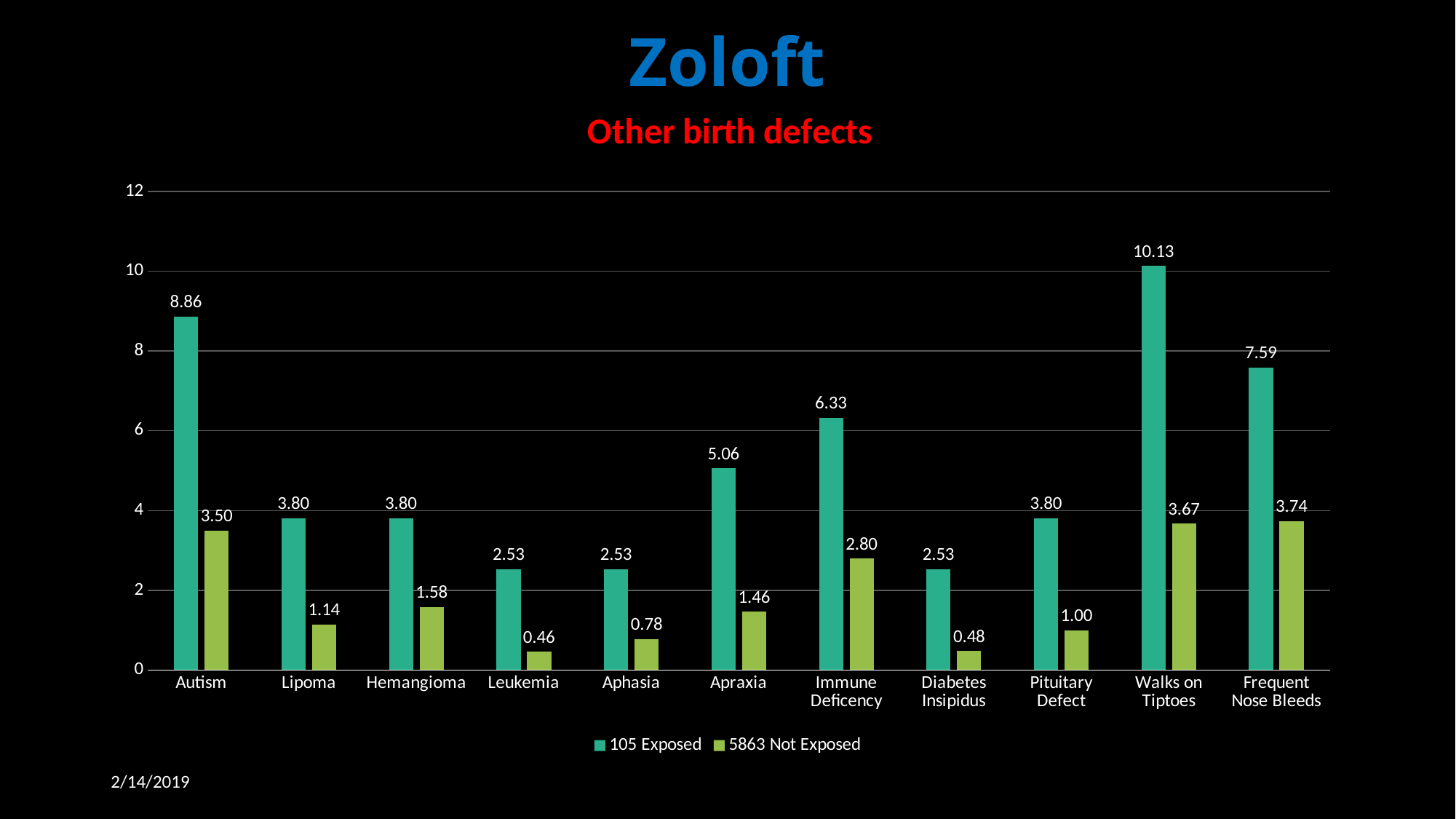
What is the value for 5863 Not Exposed for Immune Deficency? 2.80 Which category has the lowest value for 5863 Not Exposed? Leukemia Is the 105 Exposed value for Apraxia greater or less than 4? greater What kind of chart is shown on the slide? bar chart How many categories are shown on the x axis? 11 How many series does the legend list? 2 Which is larger for Pituitary Defect: the 105 Exposed value or the 5863 Not Exposed value? 105 Exposed Which category has the highest value for 105 Exposed? Walks on Tiptoes What is the value for 105 Exposed for Autism? 8.86 What is the red subtitle of the chart? Other birth defects What is the value for 5863 Not Exposed for Leukemia? 0.46 What is the difference between the 105 Exposed and 5863 Not Exposed values for Frequent Nose Bleeds? 3.85